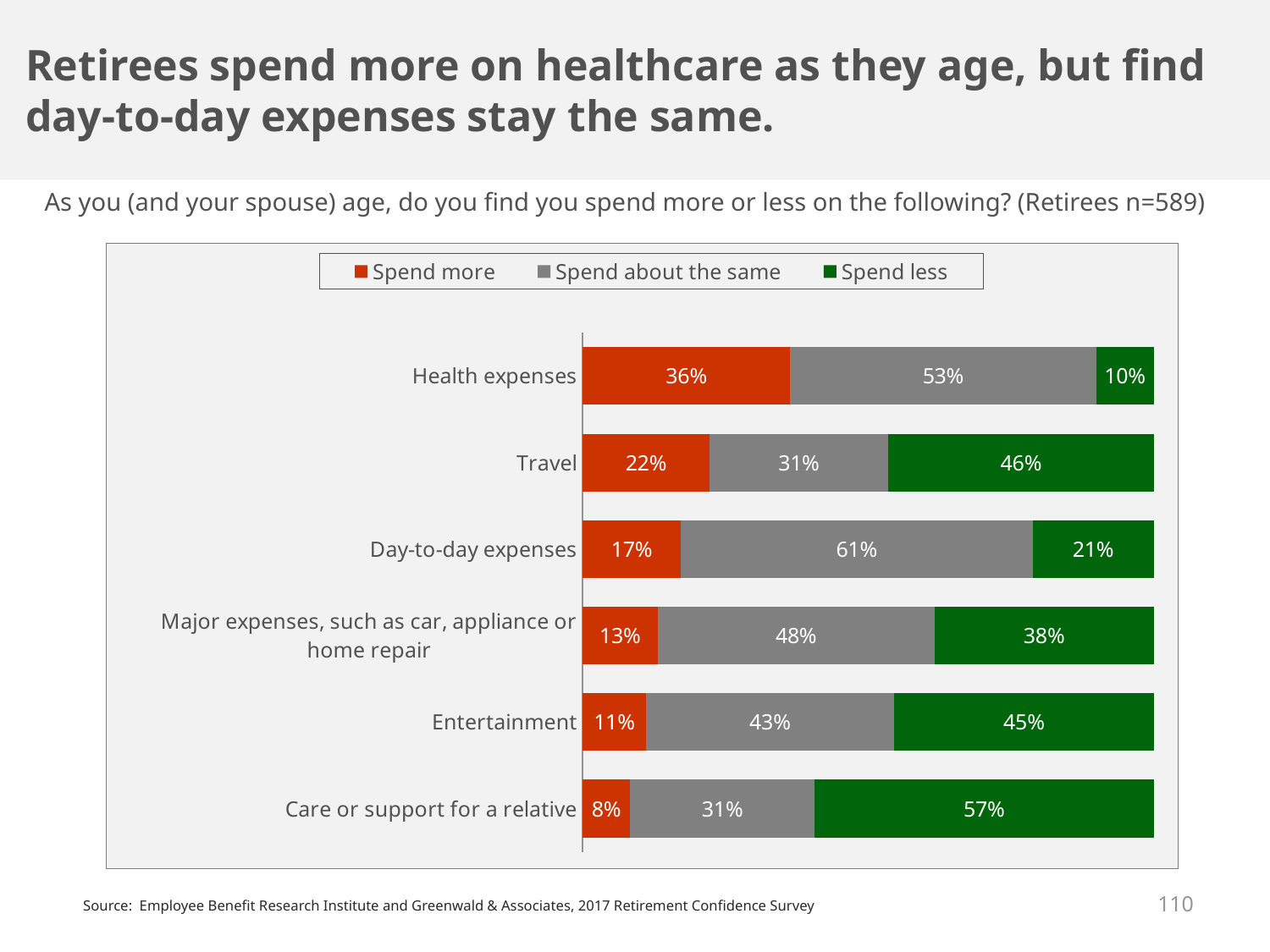
What is the difference between the 'Spend less' percentages for Travel and Entertainment? 1% What kind of chart is shown on the slide? Stacked bar chart How many series does the legend list? 3 Which is larger: the 'Spend about the same' percentage for Major expenses, such as car, appliance or home repair, or for Entertainment? Major expenses, such as car, appliance or home repair What percentage of retirees say they spend more on health expenses as they age? 36% What percentage of retirees say they spend less on care or support for a relative? 57% What percentage of retirees say they spend about the same on day-to-day expenses? 61% How many expense categories are shown in the chart? 6 Which category has the lowest 'Spend less' percentage? Health expenses Which colour represents 'Spend less' in the chart? Green What is the total of the three segments for the Travel bar? 99% Which category has the highest 'Spend more' percentage? Health expenses